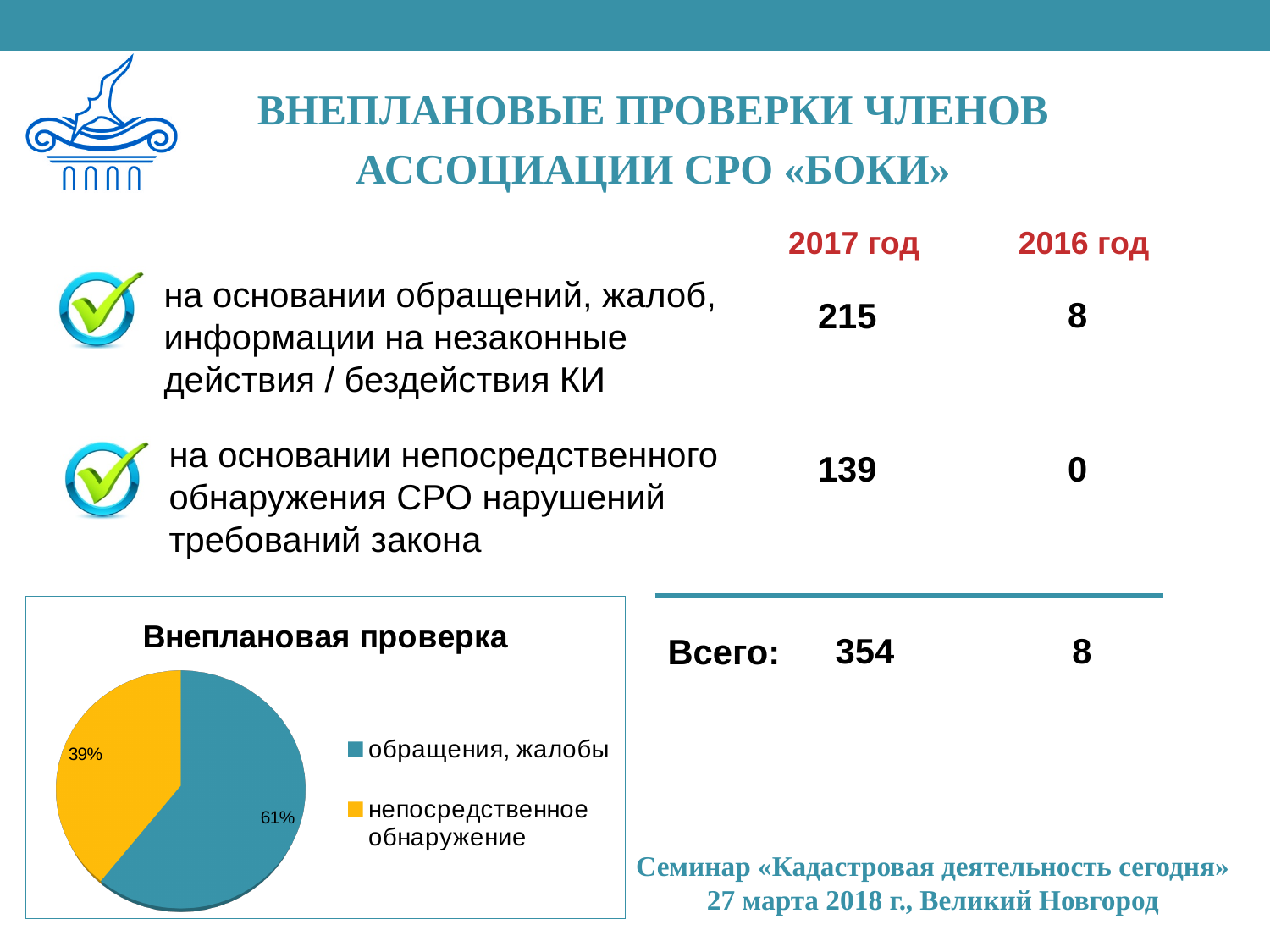
Which slice of the pie is the largest? обращения, жалобы What colour is the slice for "непосредственное обнаружение"? yellow Which slice of the pie is the smallest? непосредственное обнаружение How many slices does the pie chart have? 2 What share of the pie does the slice "обращения, жалобы" take? 61% What is the title of the chart? Внеплановая проверка What is the difference in percentage points between the "обращения, жалобы" slice and the "непосредственное обнаружение" slice? 22 How many entries does the legend list? 2 What share of the pie does the slice "непосредственное обнаружение" take? 39% What kind of chart is shown on the slide? pie chart Which is larger: the share for "обращения, жалобы" or the share for "непосредственное обнаружение"? обращения, жалобы